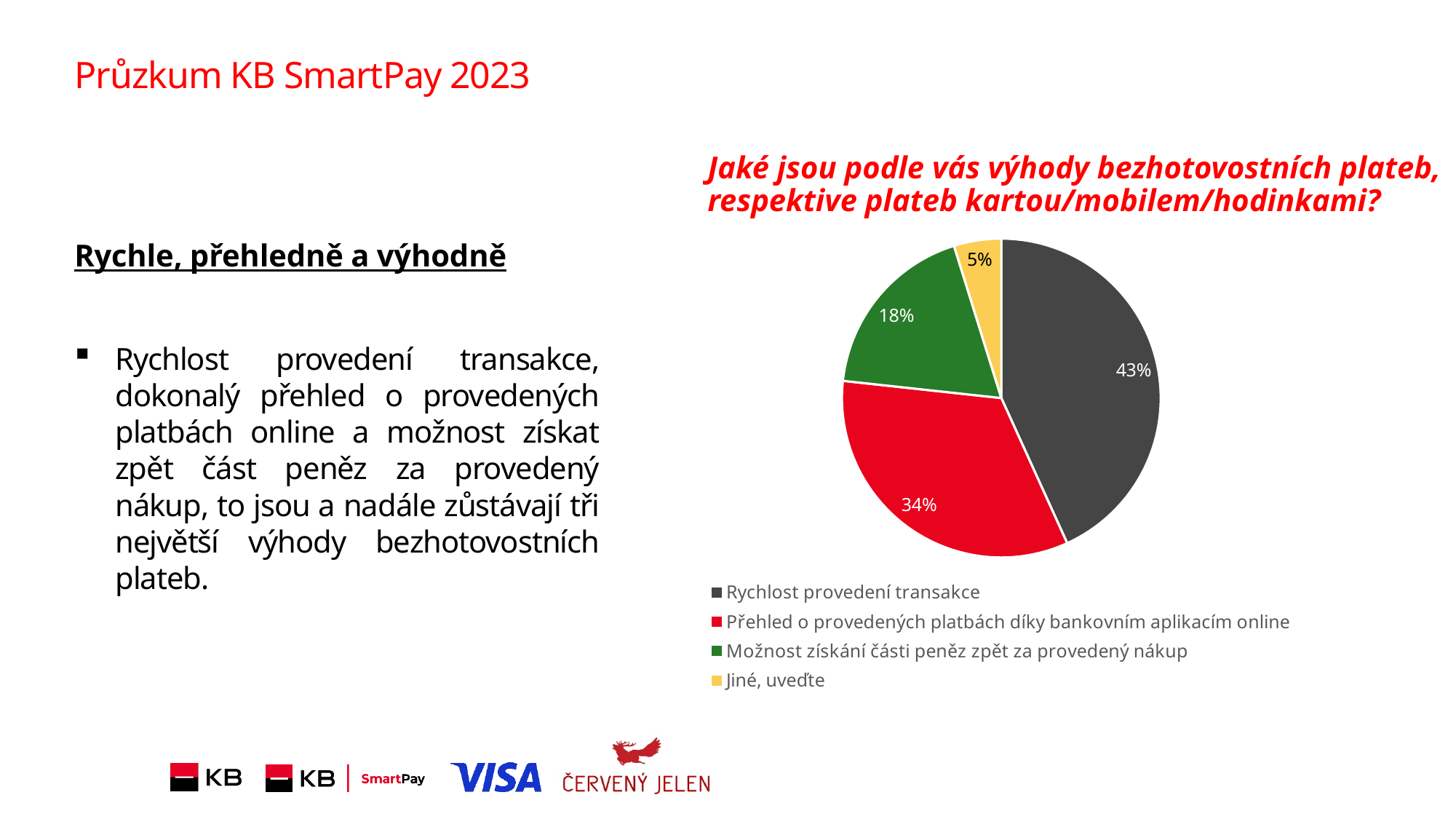
What share of the pie does 'Možnost získání části peněz zpět za provedený nákup' have? 18% How many entries does the legend list? 4 What share of the pie does 'Jiné, uveďte' have? 5% Which category has the smallest slice of the pie? Jiné, uveďte What kind of chart is shown on the slide? pie chart How many slices does the pie chart have? 4 What is the difference in percentage points between 'Rychlost provedení transakce' and 'Přehled o provedených platbách díky bankovním aplikacím online'? 9 percentage points Which is larger: the slice for 'Možnost získání části peněz zpět za provedený nákup' or the slice for 'Jiné, uveďte'? Možnost získání části peněz zpět za provedený nákup What share of the pie does 'Rychlost provedení transakce' have? 43% Which category has the largest slice of the pie? Rychlost provedení transakce What colour is the slice for 'Přehled o provedených platbách díky bankovním aplikacím online'? red What share of the pie does 'Přehled o provedených platbách díky bankovním aplikacím online' have? 34%